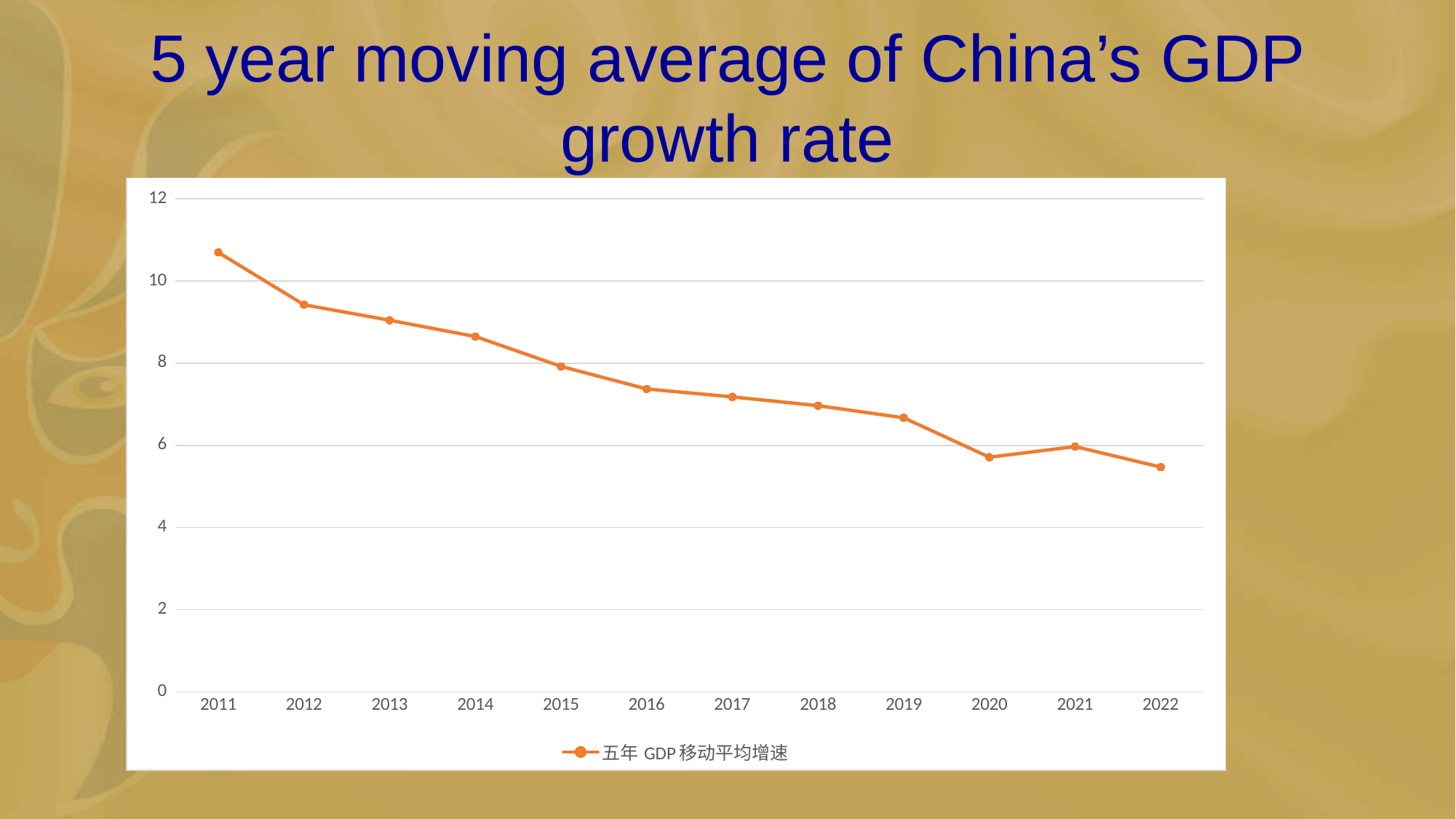
How many series does the legend list? 1 Which year has the highest value on the chart? 2011 Which year has the lowest value on the chart? 2022 Is the value for 2013 greater or less than 8? greater How many data points (years) are plotted on the chart? 12 What colour is the plotted line? Orange Which year has the larger value, 2020 or 2021? 2021 What kind of chart is shown on the slide? Line chart Is the value for 2011 greater or less than 10? greater Do the values generally rise or fall from 2011 to 2022? Fall Is the value for 2020 greater or less than 6? less